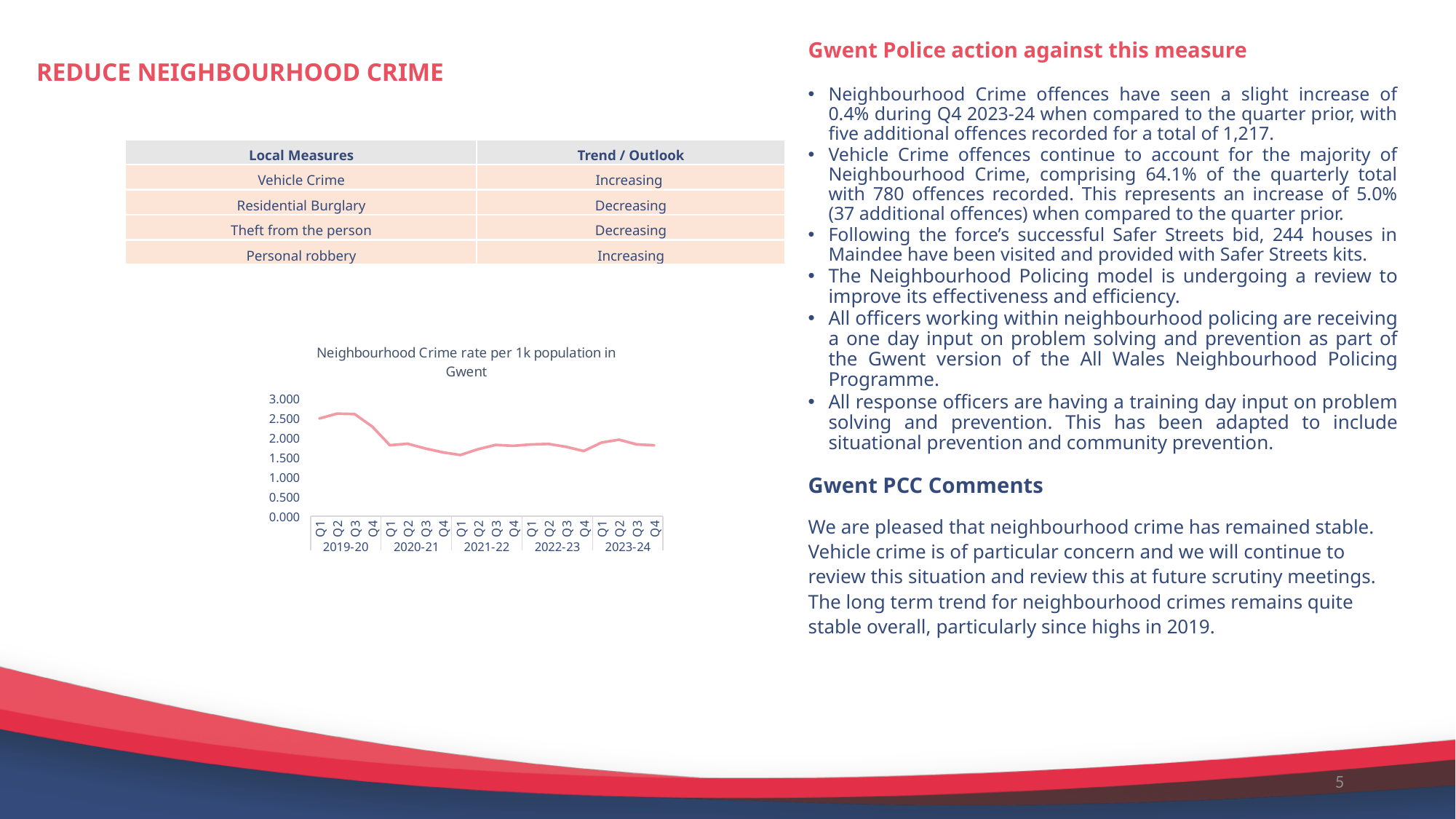
How many financial years are shown along the x axis of the chart? 5 Which is larger, the value for Q1 2019-20 or the value for Q1 2023-24? Q1 2019-20 How many quarterly data points are plotted on the chart? 20 Which is larger, the value for Q2 2019-20 or the value for Q4 2022-23? Q2 2019-20 What is the title of the chart? Neighbourhood Crime rate per 1k population in Gwent Is the value for Q1 2019-20 greater or less than 2.000? greater Is the value for Q1 2021-22 greater or less than 2.000? less Is the value for Q1 2020-21 greater or less than 2.000? less What kind of chart is shown on the slide? Line chart Overall, does the neighbourhood crime rate rise or fall from 2019-20 to 2023-24? Fall